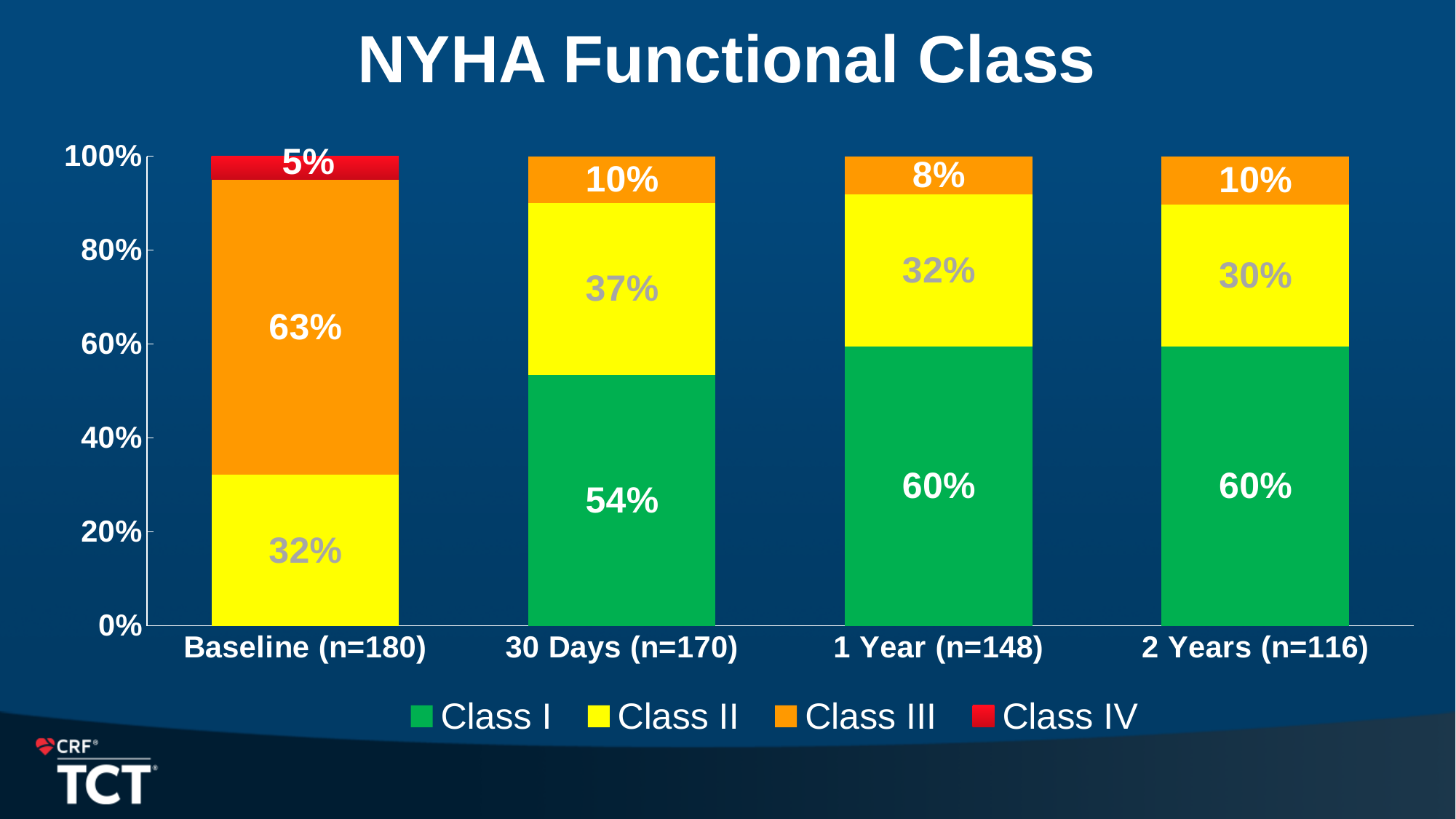
What is the Class IV value at Baseline (n=180)? 5% How many series does the legend list? 4 How many time-point categories are shown on the x axis? 4 Which is larger: the Class II value at 30 Days (n=170) or at 1 Year (n=148)? 30 Days (n=170) What is the difference between the Class I value at 1 Year (n=148) and at 30 Days (n=170)? 6% What is the title of the chart? NYHA Functional Class At which time point is the Class III value highest? Baseline (n=180) What type of chart is shown on the slide? Stacked bar chart What is the Class I value at 30 Days (n=170)? 54% What is the Class III value at Baseline (n=180)? 63% What is the Class II value at 2 Years (n=116)? 30% What is the Class III value at 1 Year (n=148)? 8%